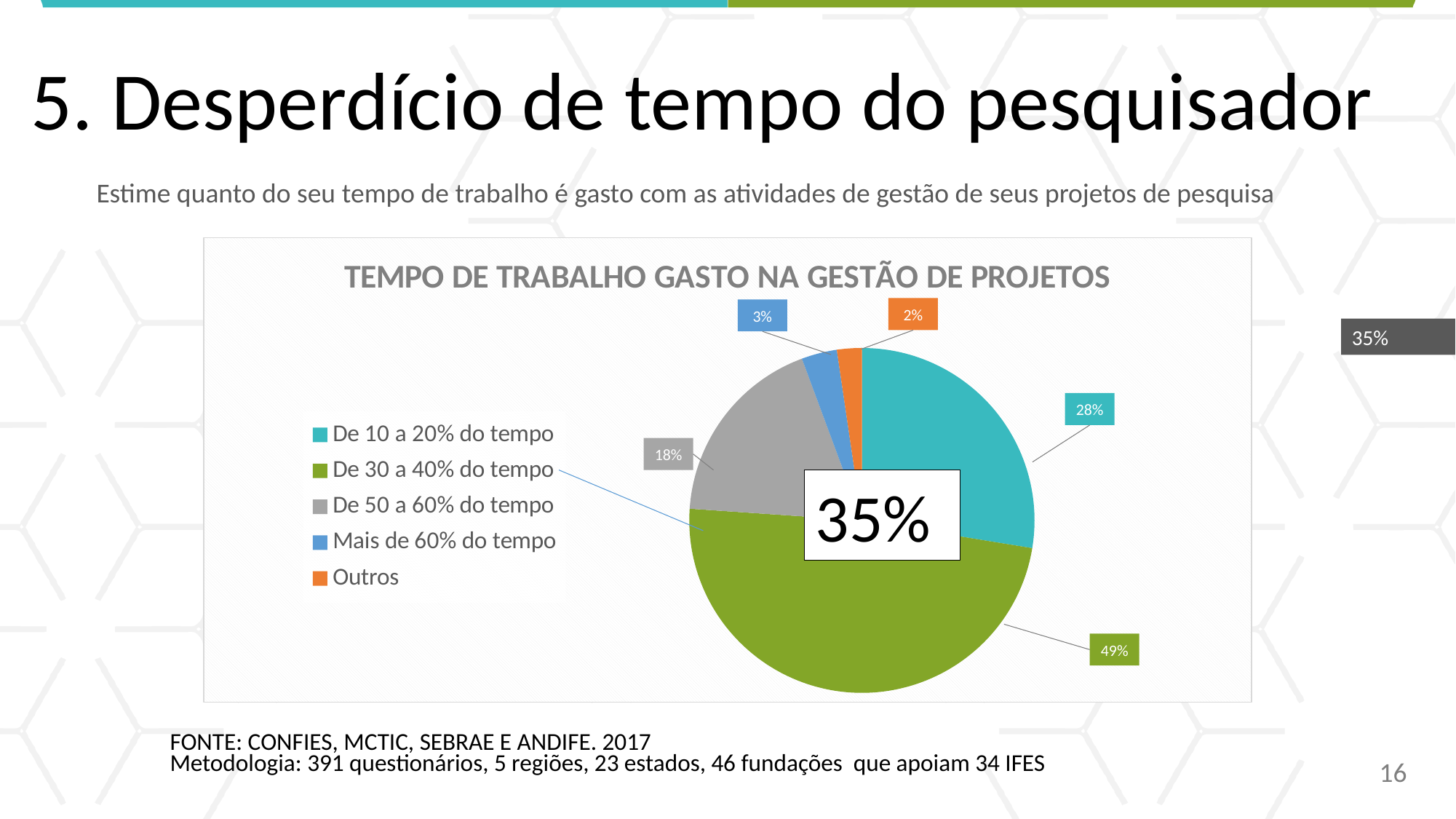
Which category has the smallest share of the pie? Outros What percentage is shown for "Mais de 60% do tempo"? 3% What percentage is shown for "De 10 a 20% do tempo"? 28% What percentage is shown for "De 30 a 40% do tempo"? 49% Which category has the largest share of the pie? De 30 a 40% do tempo What is the title of the chart? TEMPO DE TRABALHO GASTO NA GESTÃO DE PROJETOS What percentage is shown for "Outros"? 2% What is the difference in percentage points between "De 30 a 40% do tempo" and "De 10 a 20% do tempo"? 21 What percentage is shown for "De 50 a 60% do tempo"? 18% What kind of chart is shown on the slide? pie chart How many slices does the pie chart have? 5 Which is larger, the share for "De 50 a 60% do tempo" or the share for "Mais de 60% do tempo"? De 50 a 60% do tempo